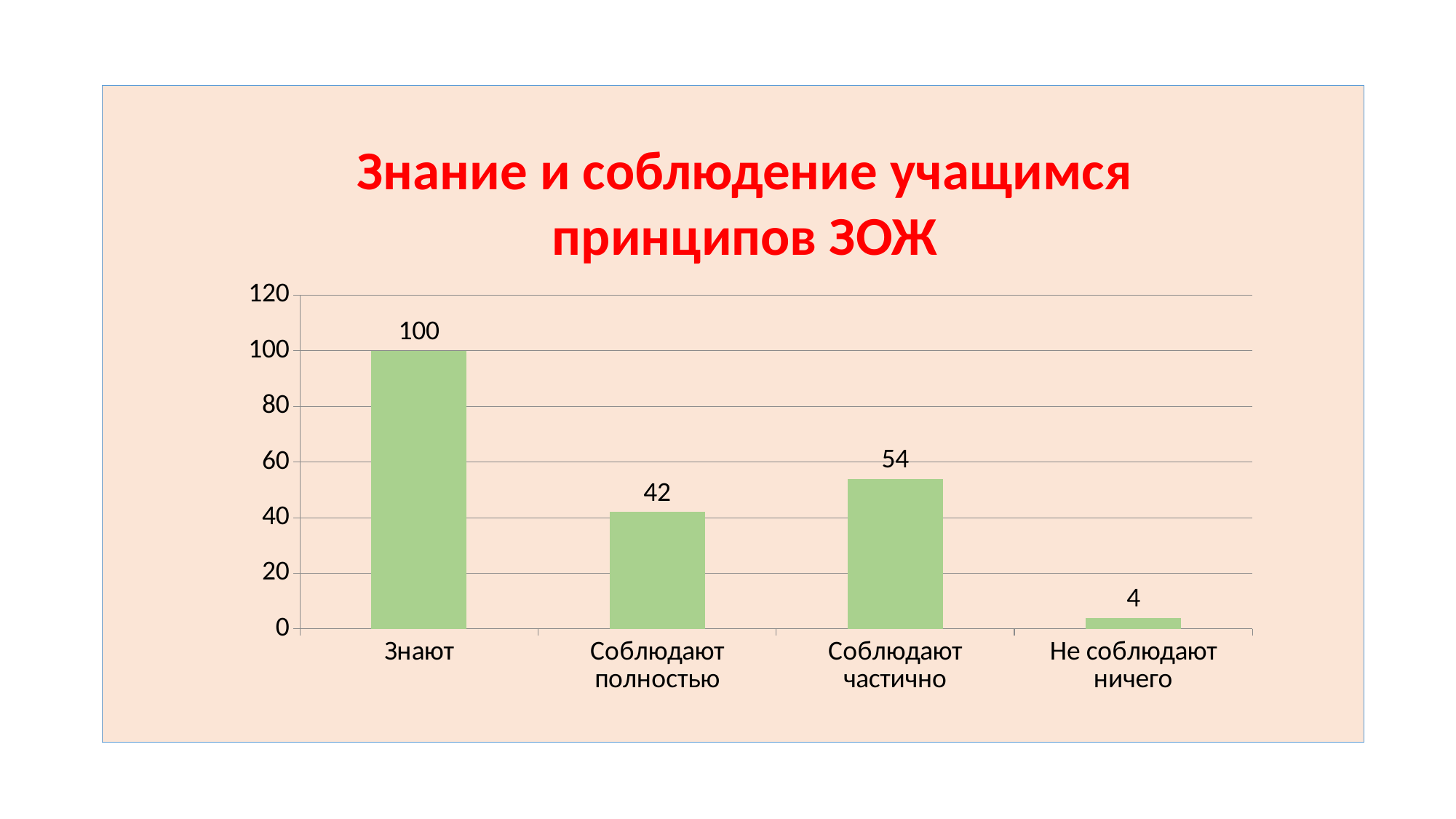
What is the value for Соблюдают полностью? 42 Which category has the lowest value? Не соблюдают ничего Which is larger, the value for Соблюдают полностью or the value for Соблюдают частично? Соблюдают частично Which category has the highest value? Знают What is the value for Не соблюдают ничего? 4 What is the title of the chart? Знание и соблюдение учащимся принципов ЗОЖ What is the difference between the values for Соблюдают частично and Соблюдают полностью? 12 How many categories are shown on the x axis? 4 What kind of chart is shown on the slide? bar chart What is the value for Соблюдают частично? 54 Is the value for Соблюдают полностью greater or less than 60? less What is the value for Знают? 100